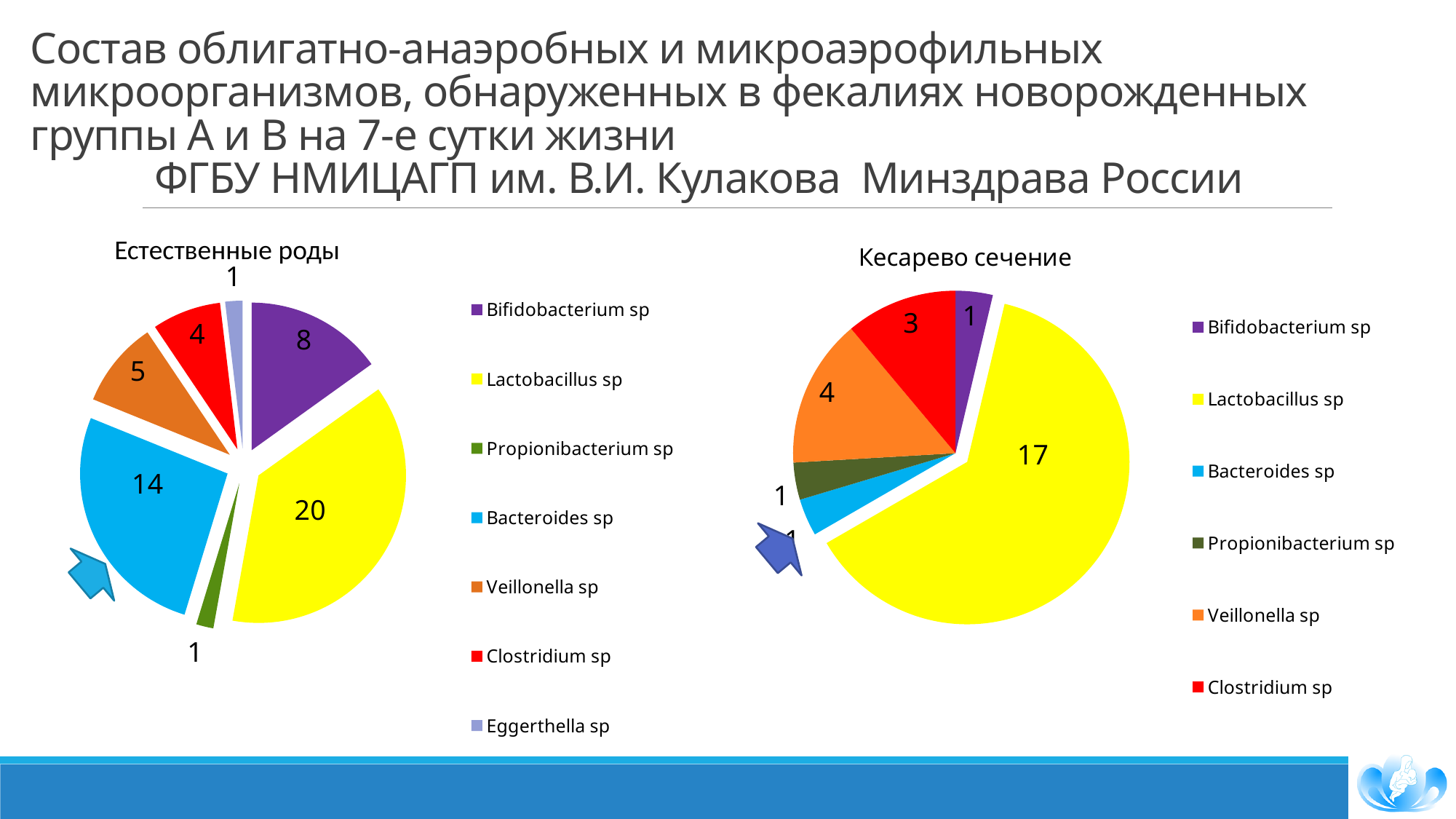
In the 'Кесарево сечение' pie chart, what is the value for Veillonella sp? 4 What is the total of all slices in the 'Естественные роды' pie chart? 53 In the 'Естественные роды' pie chart, what is the difference between the values for Lactobacillus sp and Bacteroides sp? 6 In the 'Кесарево сечение' pie chart, what is the value for Lactobacillus sp? 17 How many categories does the legend of the 'Естественные роды' chart list? 7 What type of chart is used for 'Кесарево сечение'? Pie chart In the 'Естественные роды' pie chart, which is larger: Veillonella sp or Clostridium sp? Veillonella sp In the 'Кесарево сечение' pie chart, which is larger: Clostridium sp or Bifidobacterium sp? Clostridium sp In the 'Естественные роды' pie chart, which category has the largest slice? Lactobacillus sp In the 'Кесарево сечение' pie chart, which category has the largest slice? Lactobacillus sp In the 'Естественные роды' pie chart, what is the value for Lactobacillus sp? 20 In the 'Естественные роды' pie chart, what is the value for Bacteroides sp? 14